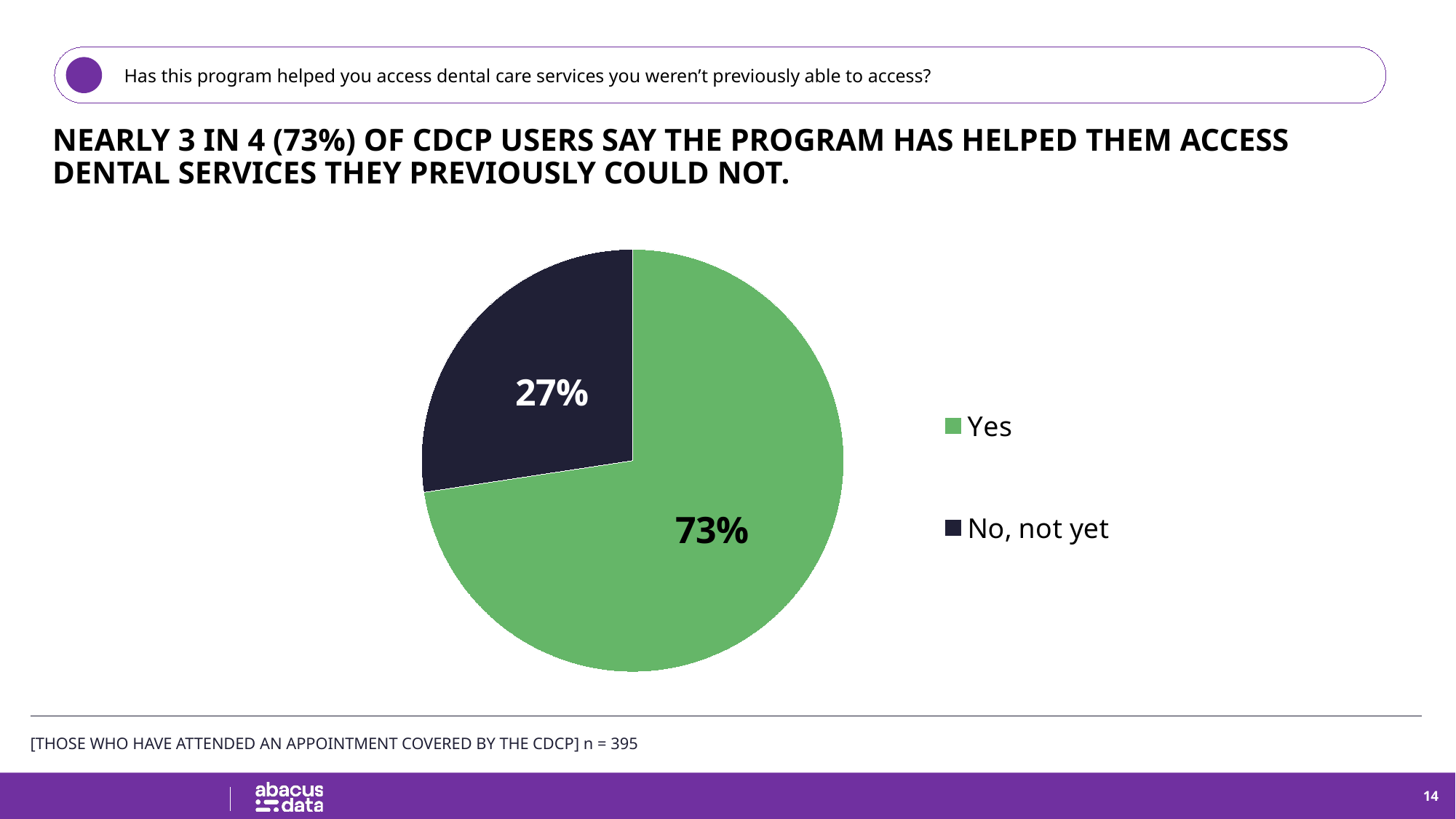
What percentage of respondents answered "Yes"? 73% How many slices does the pie chart have? 2 Which response has the largest share of the pie? Yes What share of the pie does the "No, not yet" slice represent? 27% What percentage of respondents answered "No, not yet"? 27% What kind of chart is shown on the slide? pie chart How many entries does the legend list? 2 Which response has the smallest share of the pie? No, not yet What colour is the "Yes" slice? green What is the difference in percentage points between the "Yes" and "No, not yet" slices? 46 Which is larger, the "Yes" slice or the "No, not yet" slice? Yes What is the sample size (n) noted below the chart? 395